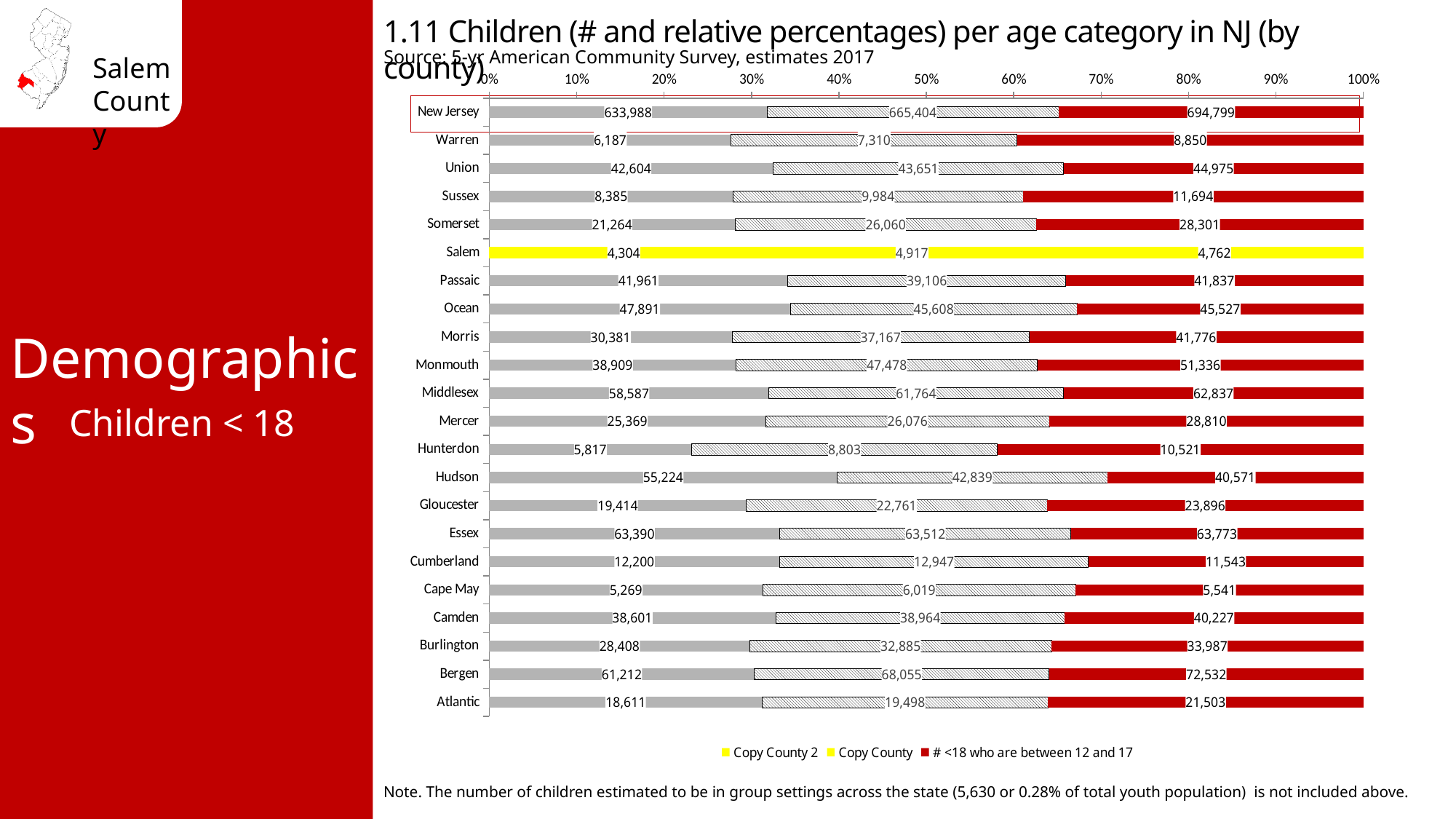
What is the value printed on the first (leftmost) segment of the Hudson bar? 55,224 What is the value printed on the first (leftmost) segment of the Salem bar? 4,304 What kind of chart is shown on the slide? Stacked bar chart Among the counties (excluding New Jersey), which has the largest '# <18 who are between 12 and 17' value? Bergen What is the value of the '# <18 who are between 12 and 17' (red) segment for Salem? 4,762 What is the total of the three segment values printed on the Salem bar? 13,983 Among the counties (excluding New Jersey), which has the smallest '# <18 who are between 12 and 17' value? Salem What is the difference between the middle segment value (4,917) and the first segment value (4,304) for Salem? 613 What is the value of the red '# <18 who are between 12 and 17' segment for Bergen? 72,532 For Hudson, which is larger: the first segment value (55,224) or the red '# <18 who are between 12 and 17' value (40,571)? 55,224 (first segment) Is the share of the first (leftmost) segment of the Hunterdon bar greater or less than 30%? less How many bars (geographic categories) are shown on the chart? 22